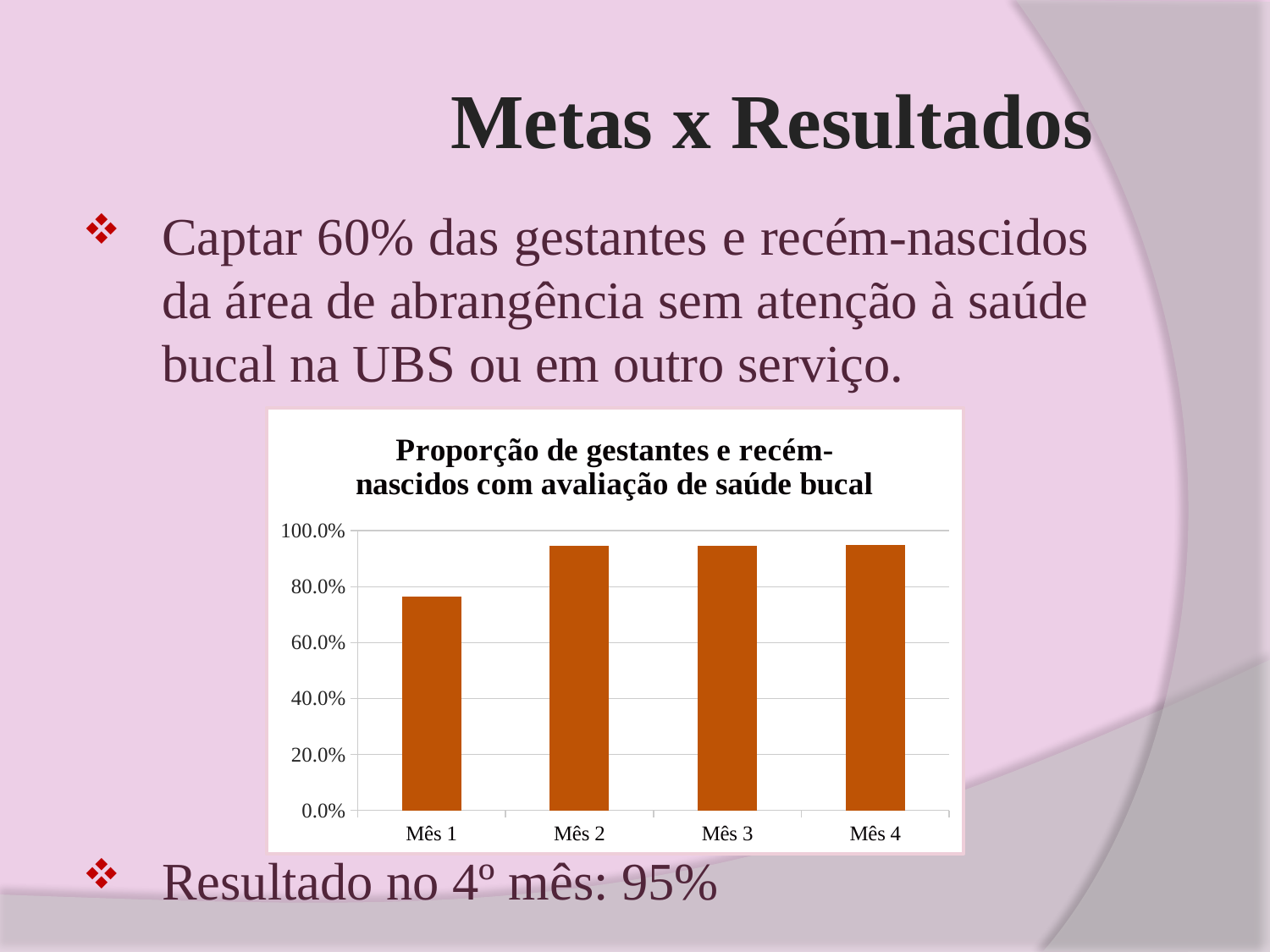
What kind of chart is shown on the slide? bar chart Is the value for Mês 1 greater or less than 80.0%? less Which month has the lowest proportion on the chart? Mês 1 Does the value rise or fall from Mês 1 to Mês 2? rise Is the value for Mês 1 greater or less than 60.0%? greater Is the value for Mês 3 greater or less than 80.0%? greater How many months (categories) are plotted on the chart? 4 What is the highest value shown on the chart's vertical axis? 100.0% According to the slide, what was the result in the 4th month (Mês 4)? 95% Which is larger, the value for Mês 1 or the value for Mês 2? Mês 2 What is the title of the chart? Proporção de gestantes e recém-nascidos com avaliação de saúde bucal